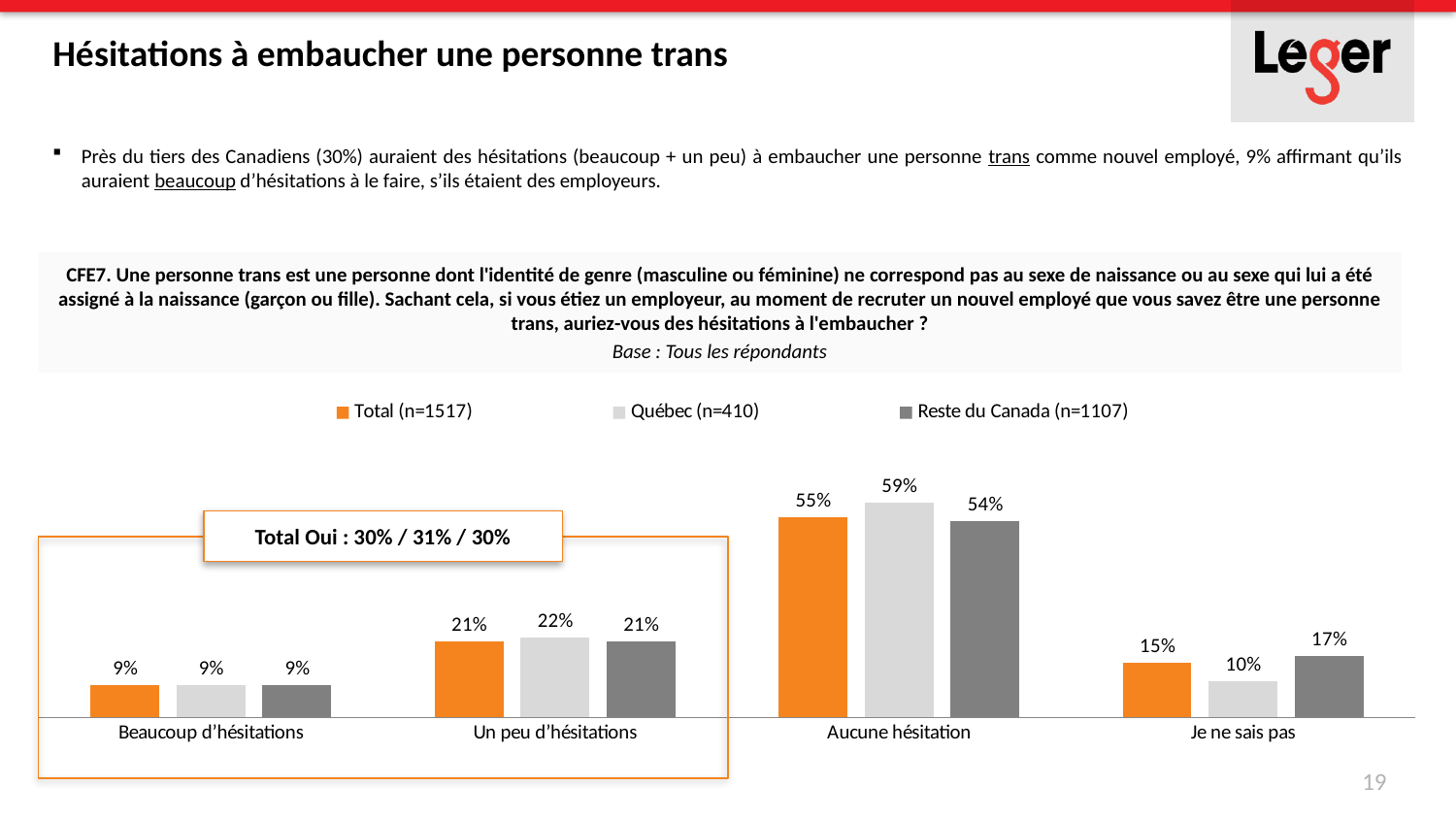
How many categories are shown on the x axis of the chart? 4 In the 'Je ne sais pas' category, which is larger: Québec (n=410) or Reste du Canada (n=1107)? Reste du Canada (n=1107) What does the boxed label above the first two categories say? Total Oui : 30% / 31% / 30% What is the difference between the Québec (n=410) and Reste du Canada (n=1107) values in the 'Aucune hésitation' category? 5% Which category has the highest value for Total (n=1517)? Aucune hésitation What is the value for Total (n=1517) in the 'Je ne sais pas' category? 15% Which series is shown in orange in the legend? Total (n=1517) What kind of chart is shown on the slide? Bar chart Which category has the lowest value for Québec (n=410)? Beaucoup d'hésitations How many series does the legend list? 3 What is the value for Reste du Canada (n=1107) in the 'Un peu d'hésitations' category? 21% What is the value for Québec (n=410) in the 'Aucune hésitation' category? 59%